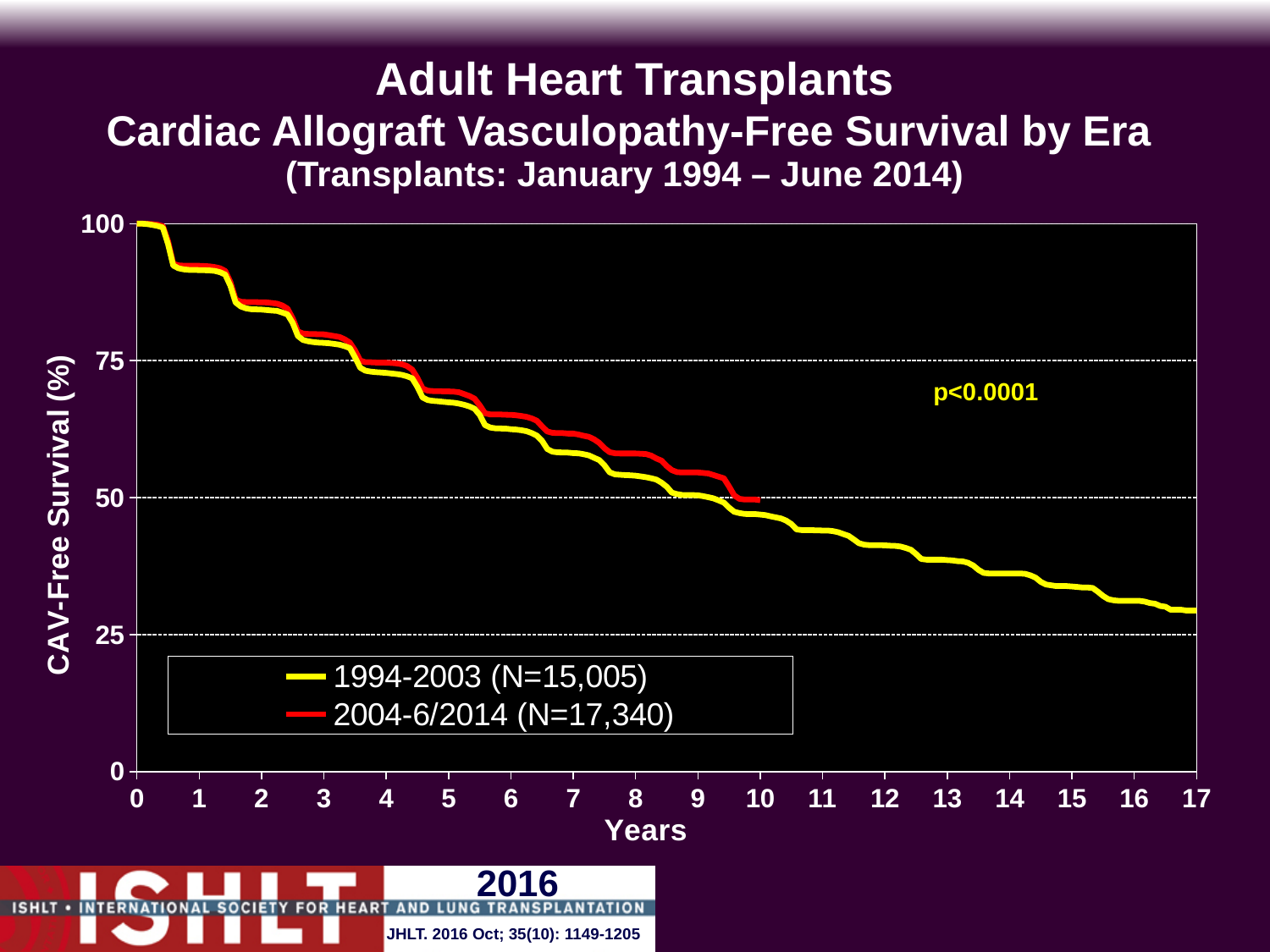
What kind of chart is shown on the slide? line chart Is the CAV-free survival for the 1994-2003 era at 15 years greater or less than 25? greater What is the sample size (N) for the 1994-2003 era shown in the legend? 15,005 What is the CAV-free survival value at 0 years for both eras? 100 At 8 years, which era has the higher CAV-free survival, 1994-2003 or 2004-6/2014? 2004-6/2014 What p-value is printed on the chart? p<0.0001 What is the sample size (N) for the 2004-6/2014 era shown in the legend? 17,340 Is the CAV-free survival for the 2004-6/2014 era at 5 years greater or less than 75? less How many series does the legend list? 2 Which two eras are compared in the legend? 1994-2003 and 2004-6/2014 Is the CAV-free survival for the 1994-2003 era at 15 years greater or less than 50? less Do the CAV-free survival curves rise or fall as years increase? fall